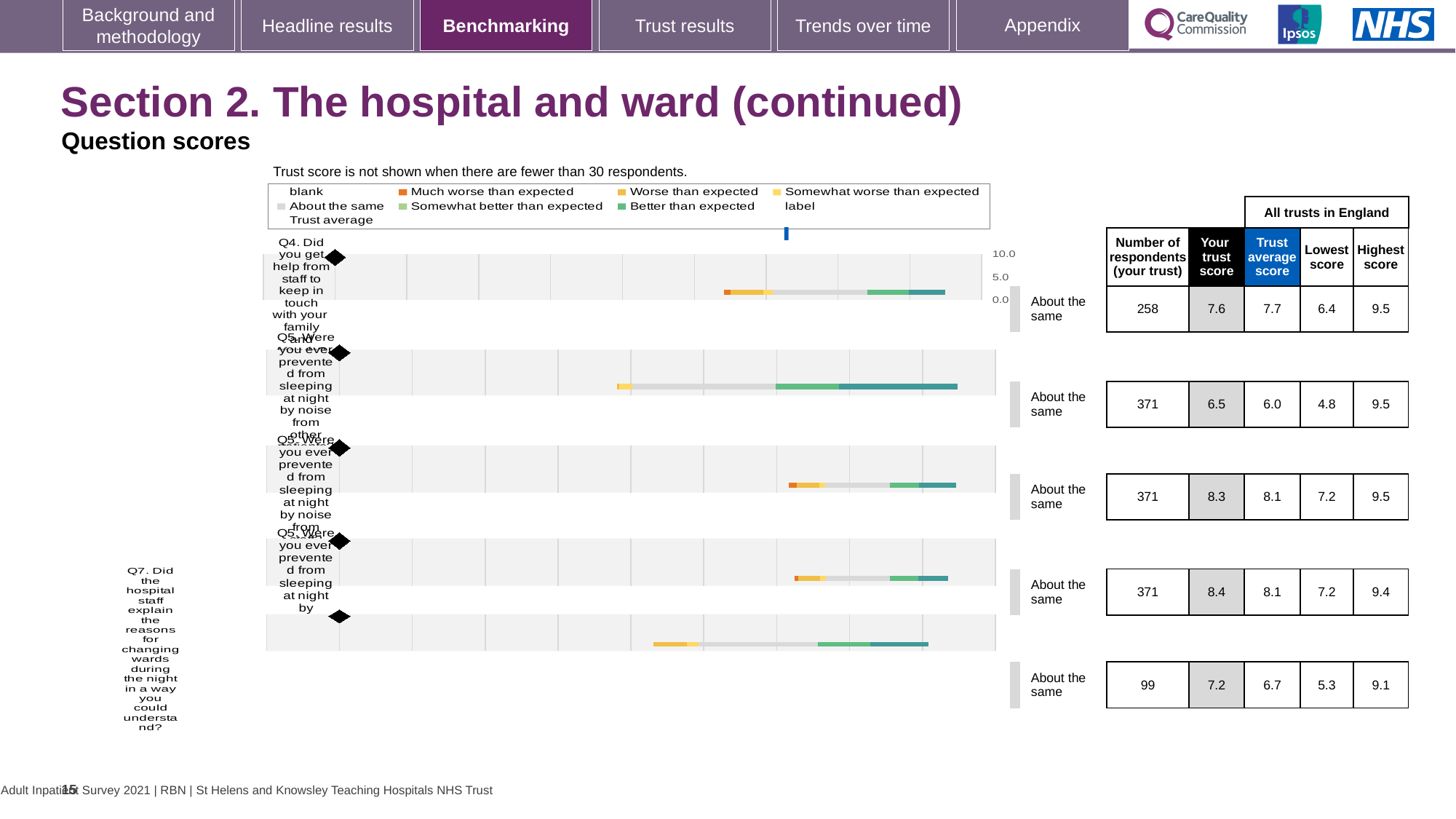
What type of chart is used to show the question scores on this slide? bar chart How many question rows (bars) are shown in the chart? 5 What is the 'Your trust score' for Q4 (help from staff to keep in touch with family and friends)? 7.6 What is the highest score across all trusts in England for Q7 (explaining reasons for changing wards during the night)? 9.1 How many respondents are listed for Q4 (help from staff to keep in touch with family and friends)? 258 What is the 'Your trust score' for Q7 (explaining reasons for changing wards during the night)? 7.2 What is the lowest 'Your trust score' shown in the table? 6.5 What benchmark category label is shown next to every question row? About the same Which row has the highest 'Your trust score' in the table? The fourth row (8.4) What is the lowest score across all trusts in England for Q4 (help from staff to keep in touch with family and friends)? 6.4 What is the difference between the highest score and the lowest score for Q4? 3.1 For Q4, which is larger: the trust's own score or the trust average score? Trust average score